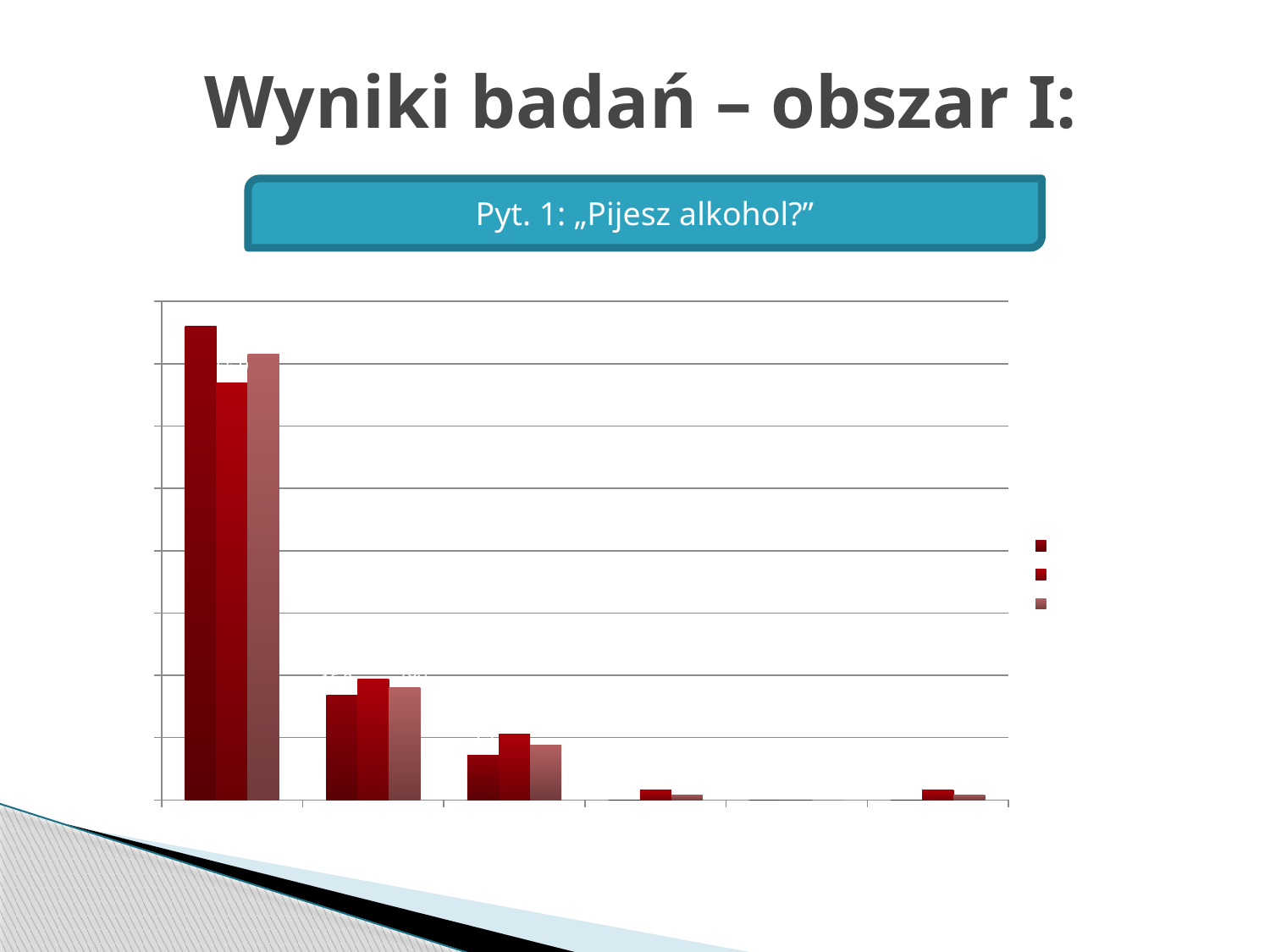
How many series does the legend list? 3 In the leftmost group of bars, is the dark red (first) bar taller or shorter than the bright red (second) bar? taller What kind of chart is shown on the slide? bar chart What is the title of the slide? Wyniki badań – obszar I: Which group of bars, counting from the left, contains the tallest bar? the first (leftmost) group Do the bar heights generally rise or fall moving from left to right along the x axis? fall In the third group of bars from the left, is the first bar taller or shorter than the second bar? shorter In the second group of bars from the left, which bar is the tallest: the first, second or third? the second What question is shown in the blue box above the chart? Pyt. 1: „Pijesz alkohol?”